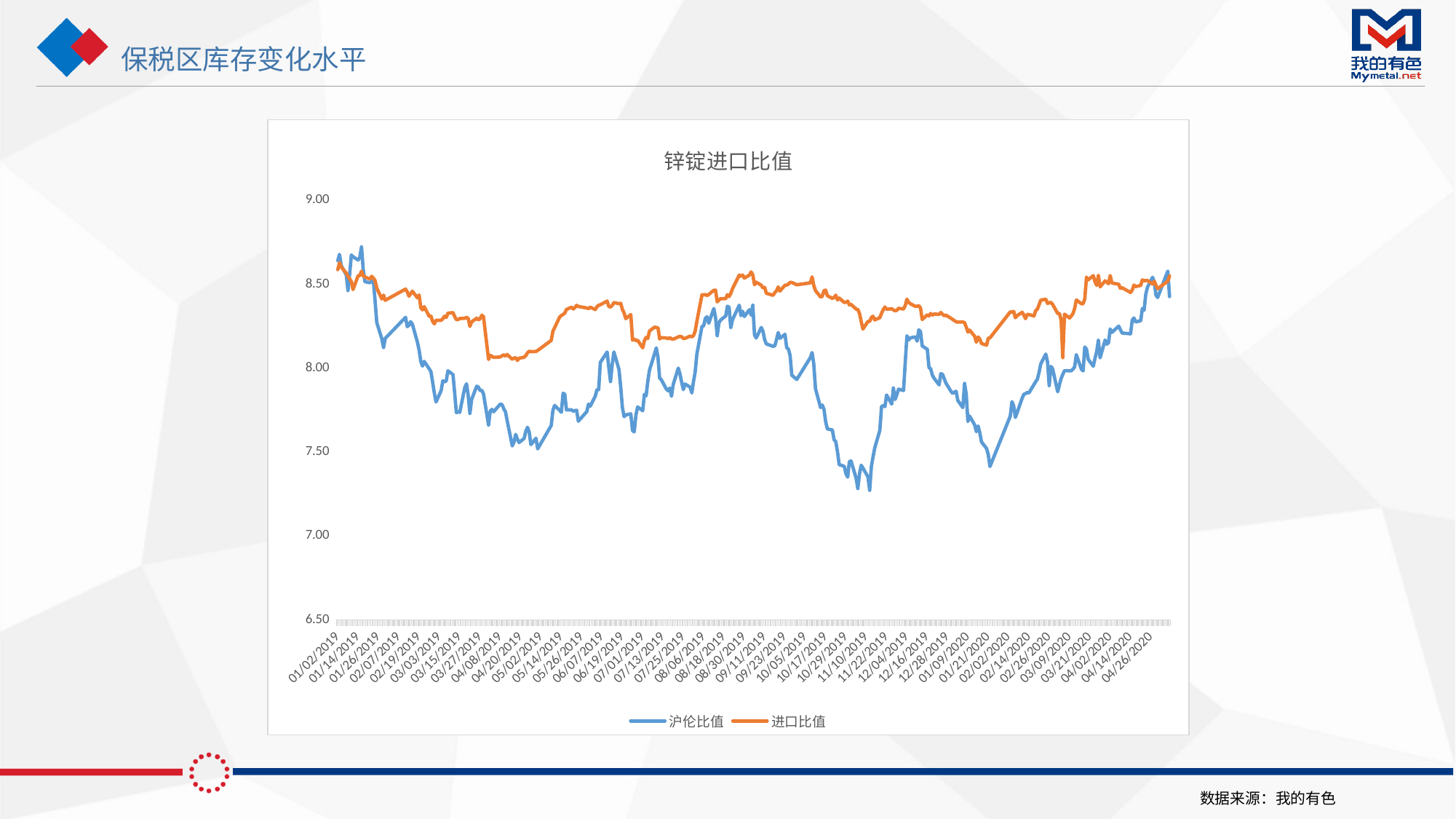
Is the value of 沪伦比值 around 01/21/2020 greater or less than 8.00? less Is the value of 进口比值 around 04/20/2019 greater or less than 8.50? less Does 沪伦比值 rise or fall between 02/02/2020 and 04/26/2020? rise Which series reaches the lowest point on the chart? 沪伦比值 What kind of chart is shown on the slide? line chart Is the value of 沪伦比值 around 11/10/2019 greater or less than 7.50? less Around 11/10/2019, which series has the higher value, 沪伦比值 or 进口比值? 进口比值 Does 沪伦比值 rise or fall between 10/05/2019 and 11/10/2019? fall How many series does the legend list? 2 What is the title of the chart? 锌锭进口比值 Which series is drawn in orange according to the legend? 进口比值